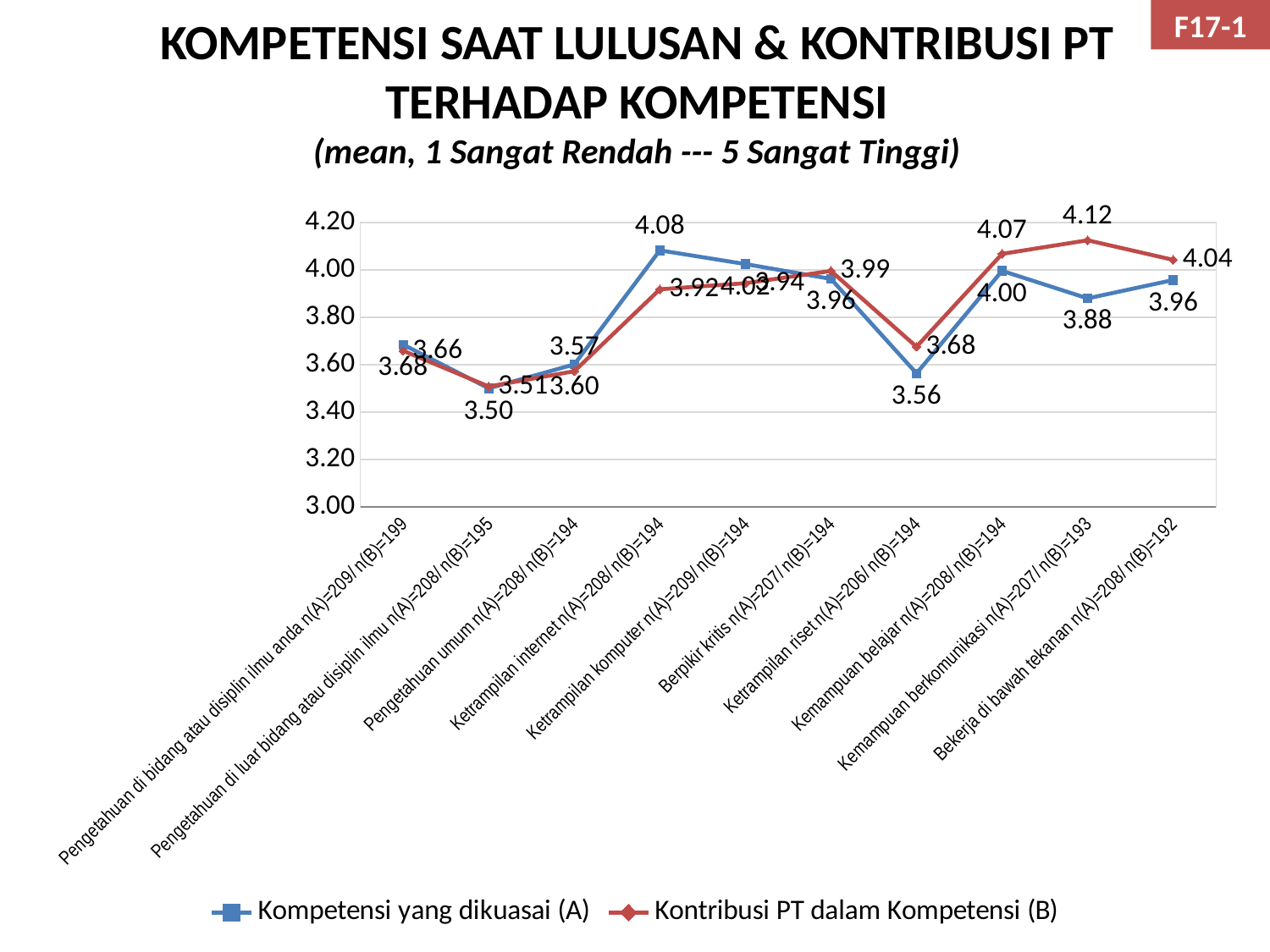
What is the value of Kontribusi PT dalam Kompetensi (B) for Kemampuan berkomunikasi? 4.12 What is the difference between Kontribusi PT dalam Kompetensi (B) and Kompetensi yang dikuasai (A) for Kemampuan berkomunikasi? 0.24 What is the value of Kontribusi PT dalam Kompetensi (B) for Bekerja di bawah tekanan? 4.04 For Ketrampilan riset, which series has the higher value? Kontribusi PT dalam Kompetensi (B) How many series does the legend list? 2 Which series is drawn in red? Kontribusi PT dalam Kompetensi (B) What is the value of Kompetensi yang dikuasai (A) for Ketrampilan internet? 4.08 For which category is Kontribusi PT dalam Kompetensi (B) highest? Kemampuan berkomunikasi What is the value of Kompetensi yang dikuasai (A) for Ketrampilan riset? 3.56 What kind of chart is shown on the slide? line chart How many categories are plotted along the x axis? 10 For which category is Kompetensi yang dikuasai (A) lowest? Pengetahuan di luar bidang atau disiplin ilmu